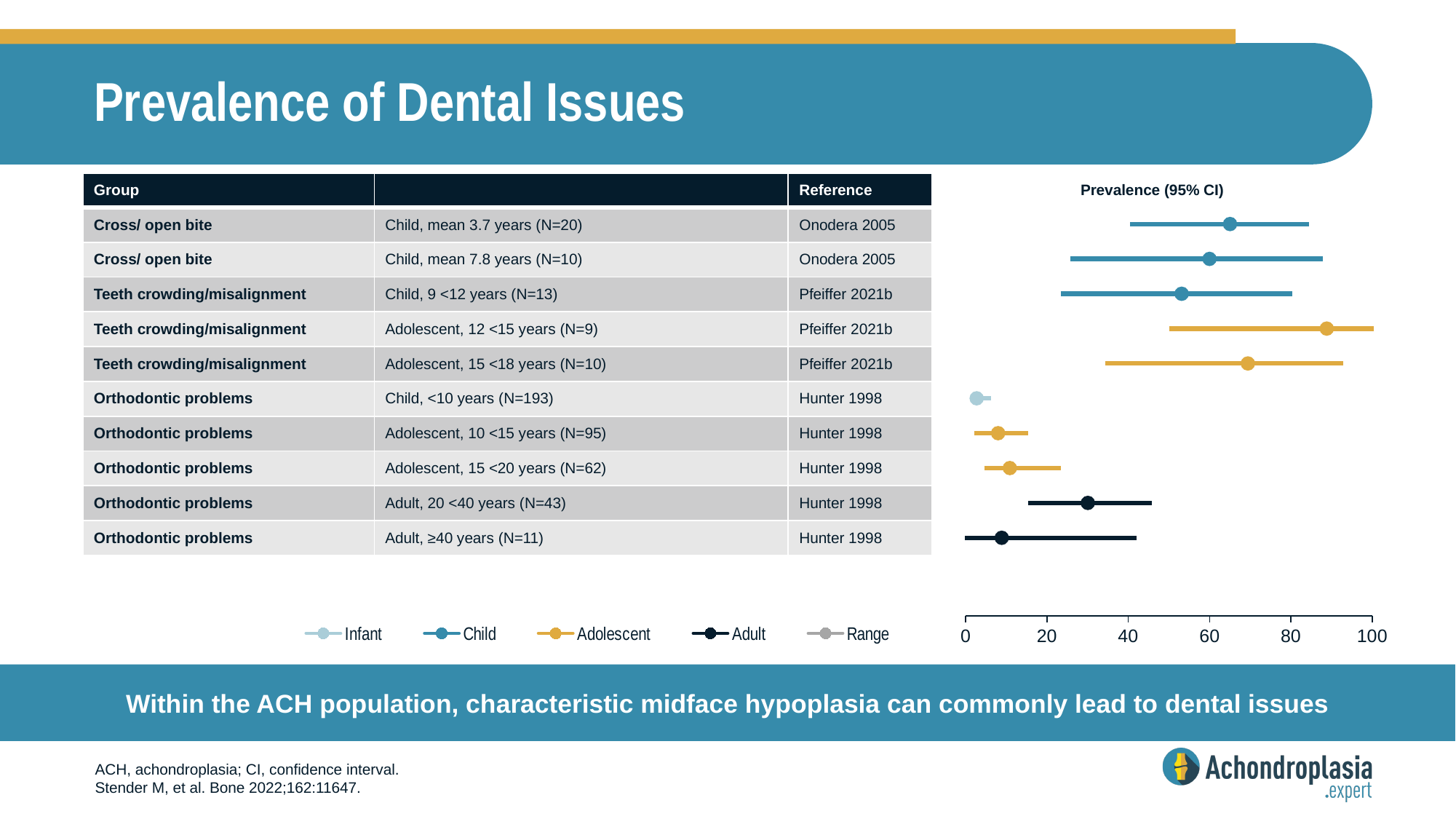
Which row has the lowest point estimate of prevalence in the chart? Orthodontic problems, Child, <10 years (N=193) Which row has the highest point estimate of prevalence in the chart? Teeth crowding/misalignment, Adolescent, 12 <15 years (N=9) Is the prevalence point estimate for Teeth crowding/misalignment, Child, 9 <12 years (N=13) greater or less than 40? greater How many series does the legend of the Prevalence (95% CI) chart list? 5 What kind of chart is used to show Prevalence (95% CI)? Forest plot (dot plot with confidence interval bars) Which has the higher prevalence point estimate for Orthodontic problems: Adult, 20 <40 years (N=43) or Adult, ≥40 years (N=11)? Adult, 20 <40 years (N=43) How many rows (groups) are plotted in the Prevalence (95% CI) chart? 10 Which has the higher prevalence point estimate: Teeth crowding/misalignment in Adolescents 12 <15 years or in Adolescents 15 <18 years? Adolescent, 12 <15 years (N=9) Is the prevalence point estimate for Cross/ open bite, Child, mean 3.7 years (N=20) greater or less than 60? greater What is the title shown above the chart? Prevalence (95% CI) Is the prevalence point estimate for Orthodontic problems, Adult, ≥40 years (N=11) greater or less than 20? less